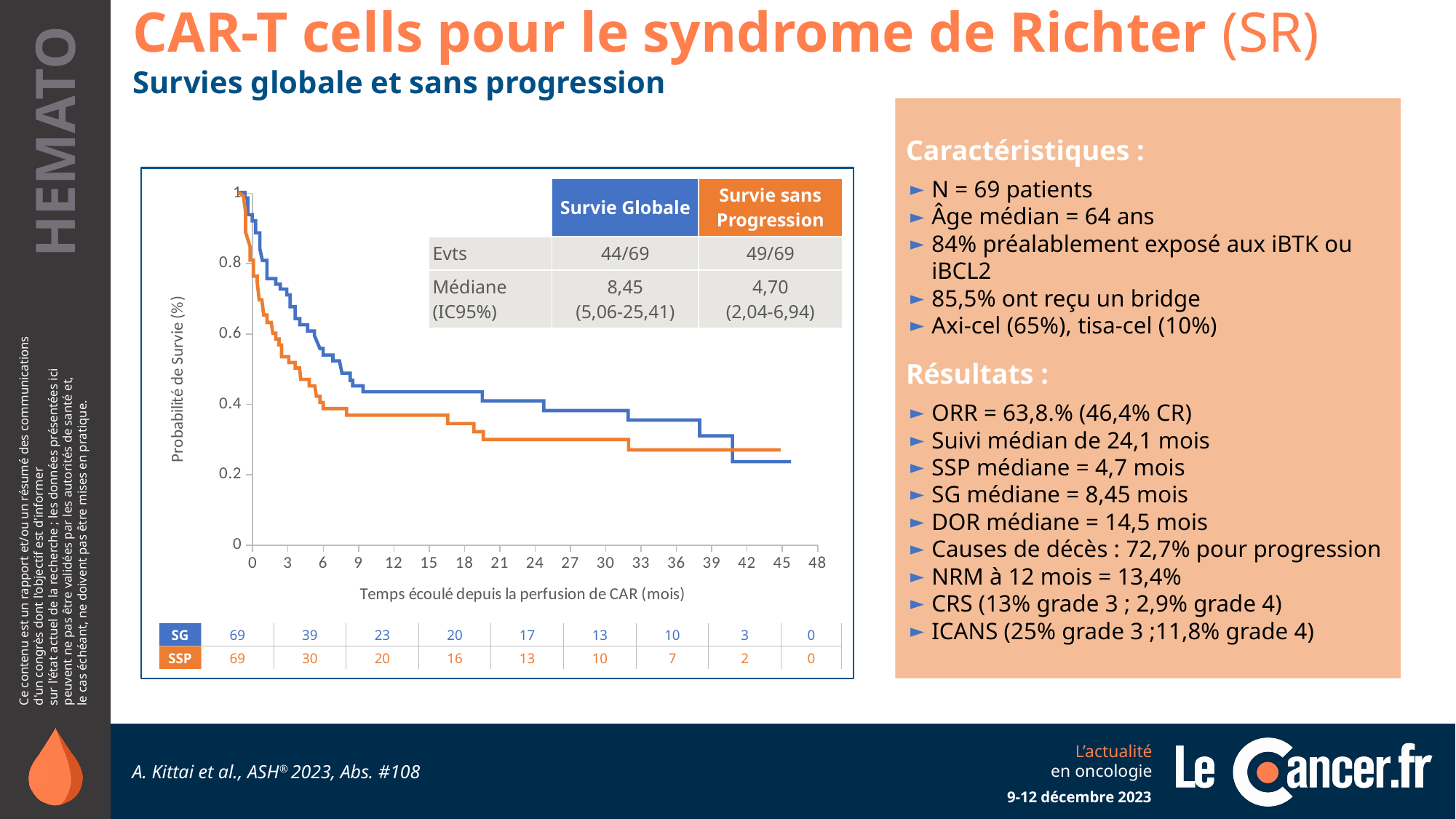
What kind of chart is shown on the slide? line chart (Kaplan-Meier survival curves) What is the median Survie Globale shown in the table on the chart? 8,45 How many events (Evts) are reported for Survie sans Progression? 49/69 How many survival curves are plotted on the chart? 2 What is the difference between the median Survie Globale and the median Survie sans Progression? 3,75 Is the Survie Globale (blue) curve greater or less than 0.4 at 12 months? greater Is the Survie sans Progression (orange) curve greater or less than 0.4 at 24 months? less Which has the larger median, Survie Globale or Survie sans Progression? Survie Globale What is the median Survie sans Progression shown in the table on the chart? 4,70 What is the title of the x axis of the chart? Temps écoulé depuis la perfusion de CAR (mois) How many events (Evts) are reported for Survie Globale? 44/69 Do the survival curves rise or fall as time since CAR infusion increases? fall